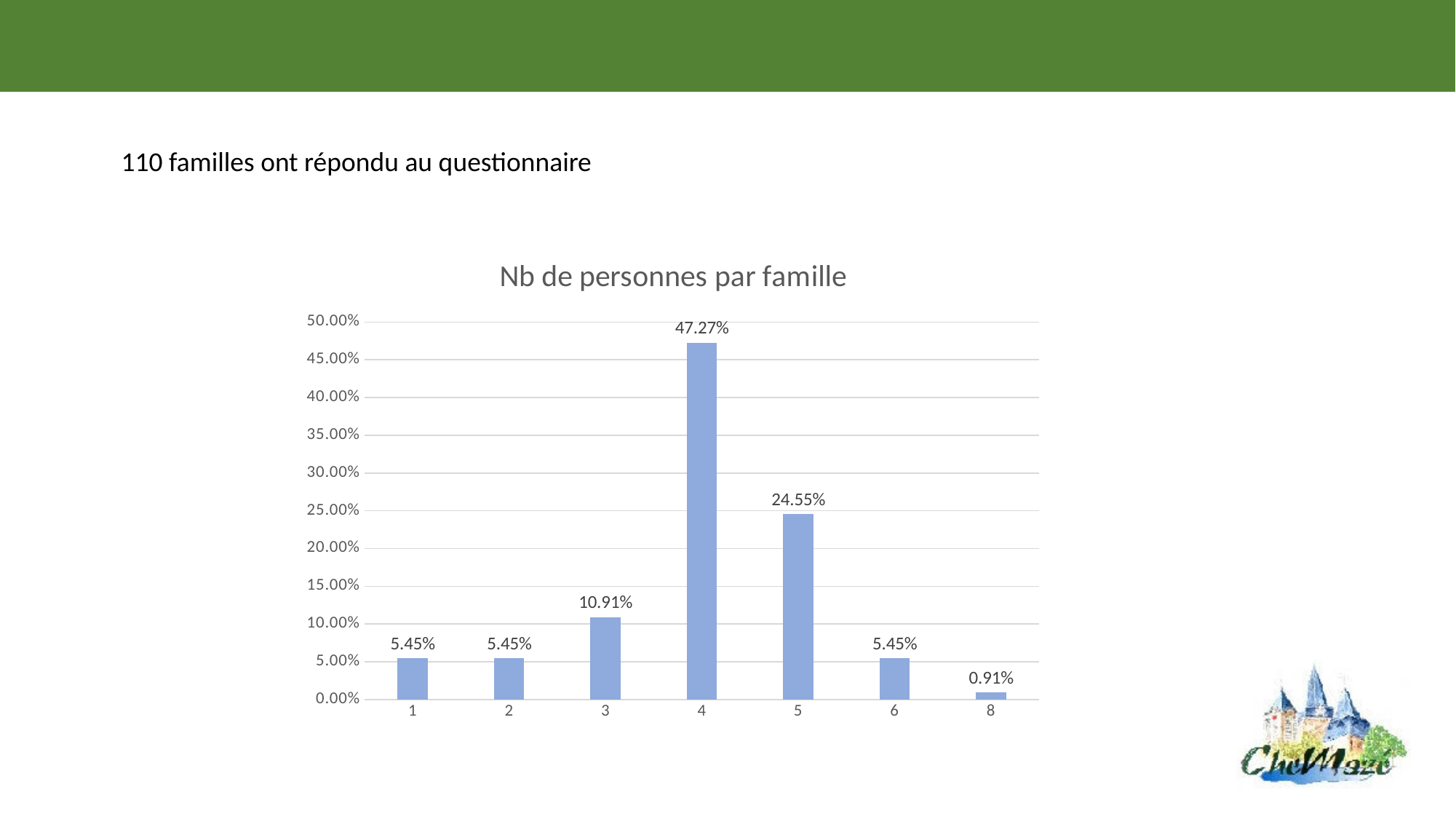
What kind of chart is this? bar chart What is the value for category 5? 24.55% How many categories are shown on the x axis? 7 What is the difference between the values for category 4 and category 5? 22.72% What is the value for category 3? 10.91% What is the value for category 8? 0.91% Which is larger, the value for category 3 or the value for category 6? 3 Is the value for category 5 greater or less than 20.00%? greater What is the value for category 4? 47.27% Which category has the lowest value? 8 What is the title of the chart? Nb de personnes par famille Which category has the highest value? 4